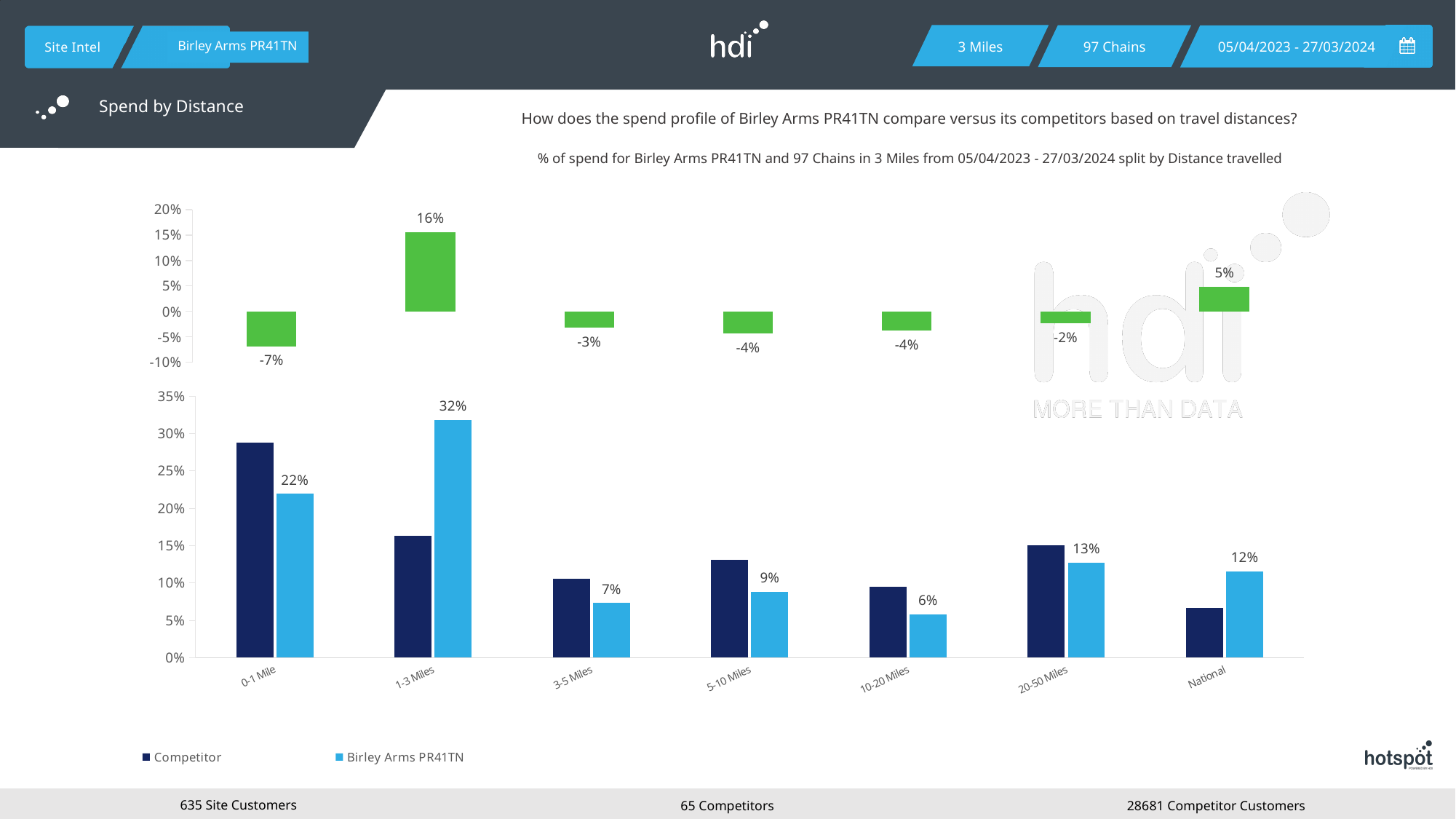
In the top chart, which distance band has the lowest value? 0-1 Mile In the bottom chart, what is the difference between the Birley Arms PR41TN values at 1-3 Miles and 0-1 Mile? 10% In the bottom chart, what is the value for Birley Arms PR41TN at 1-3 Miles? 32% In the bottom chart, which is larger at 20-50 Miles: the Competitor value or the Birley Arms PR41TN value? Competitor In the bottom chart, is the Competitor value at 0-1 Mile greater or less than 25%? greater How many series does the legend of the bottom chart list? 2 In the bottom chart, is the Competitor value at National greater or less than 10%? less In the bottom chart, what is the value for Birley Arms PR41TN at 10-20 Miles? 6% In the top chart, what is the value shown for 1-3 Miles? 16% How many distance categories are shown on the x axis of the bottom chart? 7 In the bottom chart, which distance band has the highest value for Birley Arms PR41TN? 1-3 Miles In the top chart, what is the value shown for 0-1 Mile? -7%